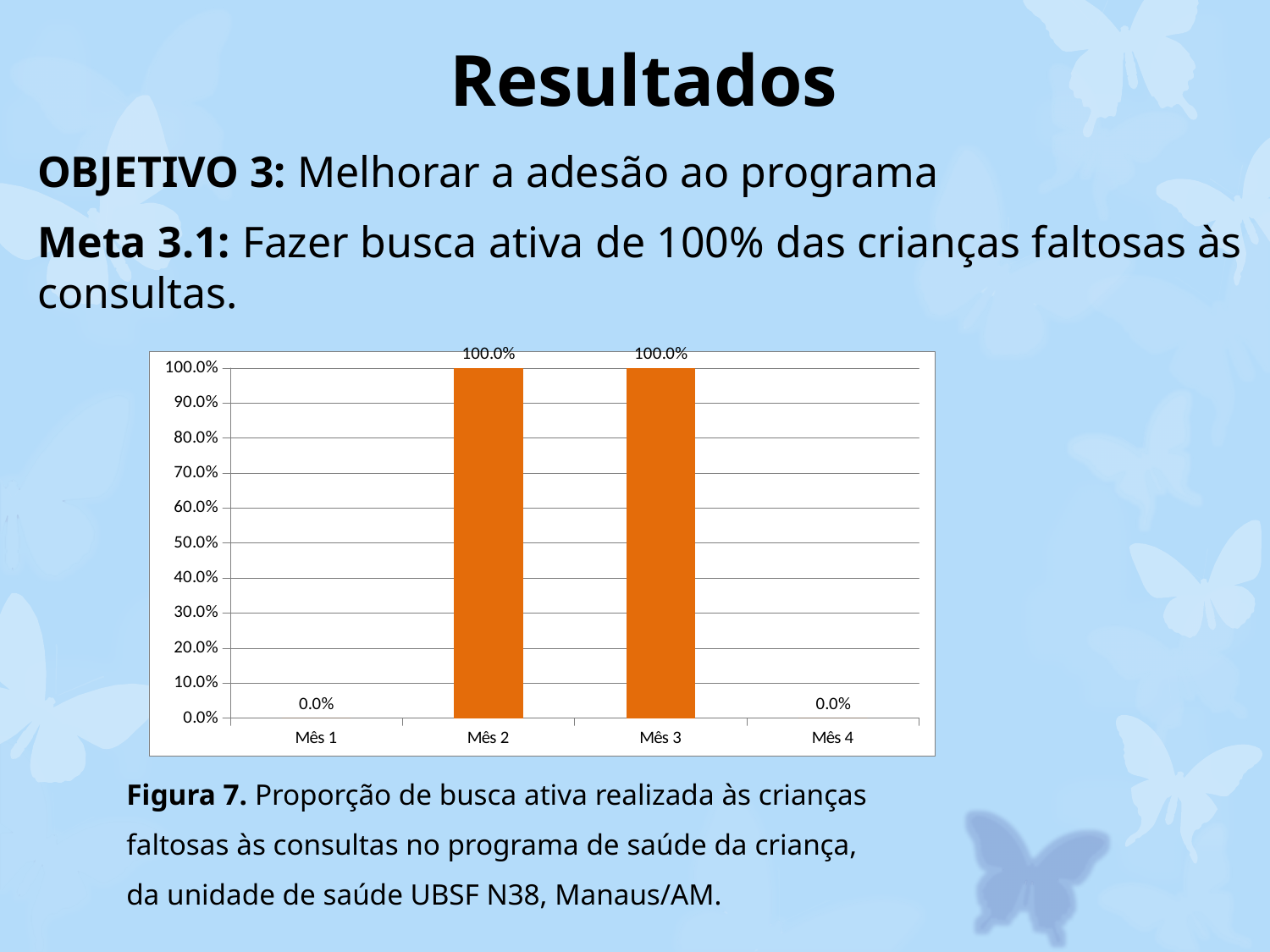
What is the value for Mês 2? 100.0% What is the highest value shown on the y axis of the chart? 100.0% What colour are the bars in the chart? Orange What is the value for Mês 1? 0.0% What kind of chart is shown on the slide? Bar chart Is the value for Mês 4 greater or less than 10.0%? less How many categories are shown on the x axis of the chart? 4 Which is larger, the value for Mês 3 or the value for Mês 4? Mês 3 What is the value for Mês 3? 100.0% What is the value for Mês 4? 0.0% Is the value for Mês 2 greater or less than 50.0%? greater What is the difference between the values for Mês 2 and Mês 1? 100.0%